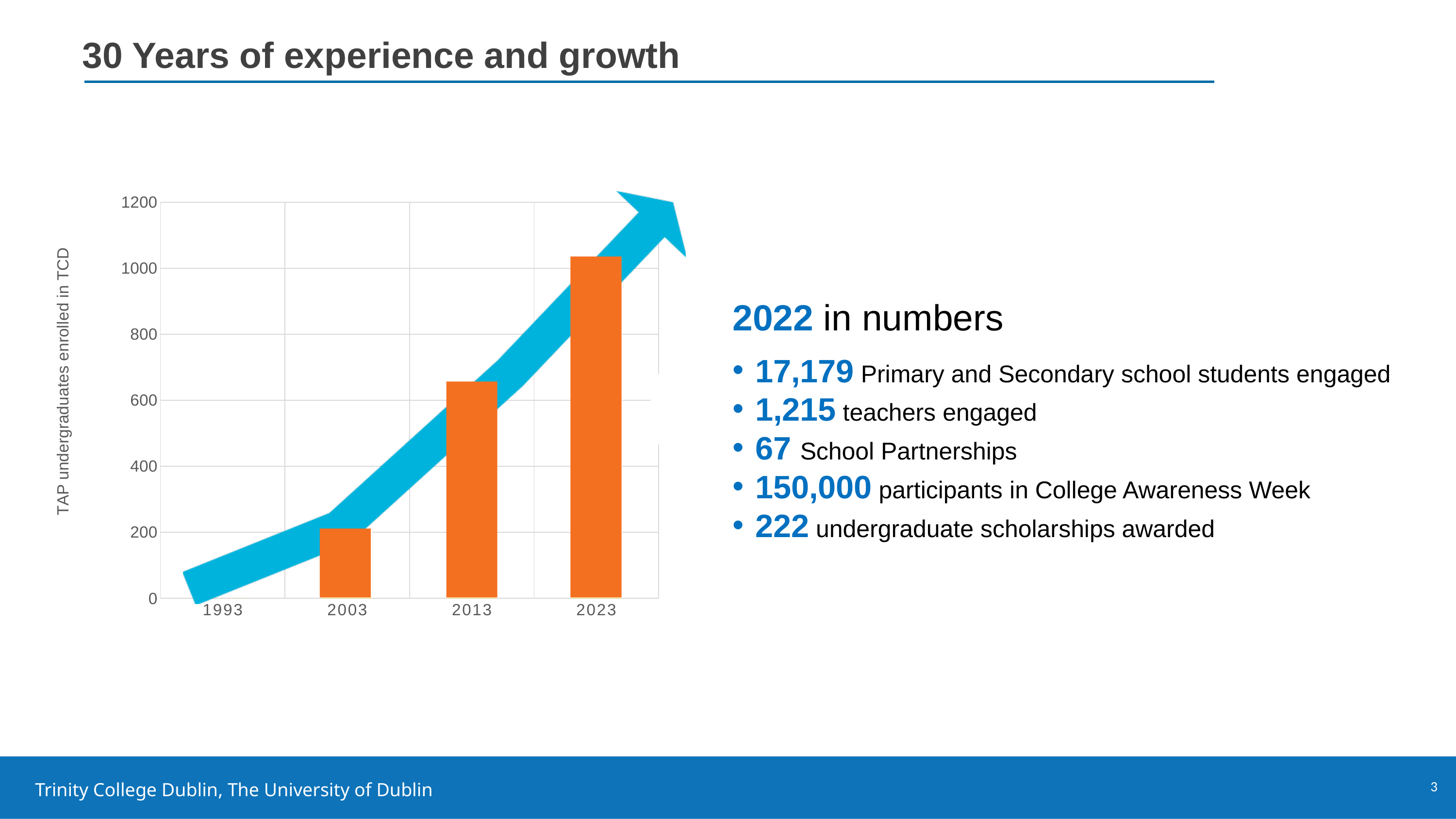
Is the value for 2023 greater or less than 1000? greater What kind of chart is shown on the slide? bar chart Which is larger, the value for 2013 or the value for 2023? 2023 How many years are labelled on the x axis of the chart? 4 Is the value for 2003 greater or less than 400? less Do the bar values rise or fall from 2003 to 2023? rise Which is larger, the value for 2003 or the value for 2013? 2013 Is the value for 2013 greater or less than 600? greater Which year has the tallest bar in the chart? 2023 What is the label on the y axis of the chart? TAP undergraduates enrolled in TCD What colour are the bars in the chart? orange